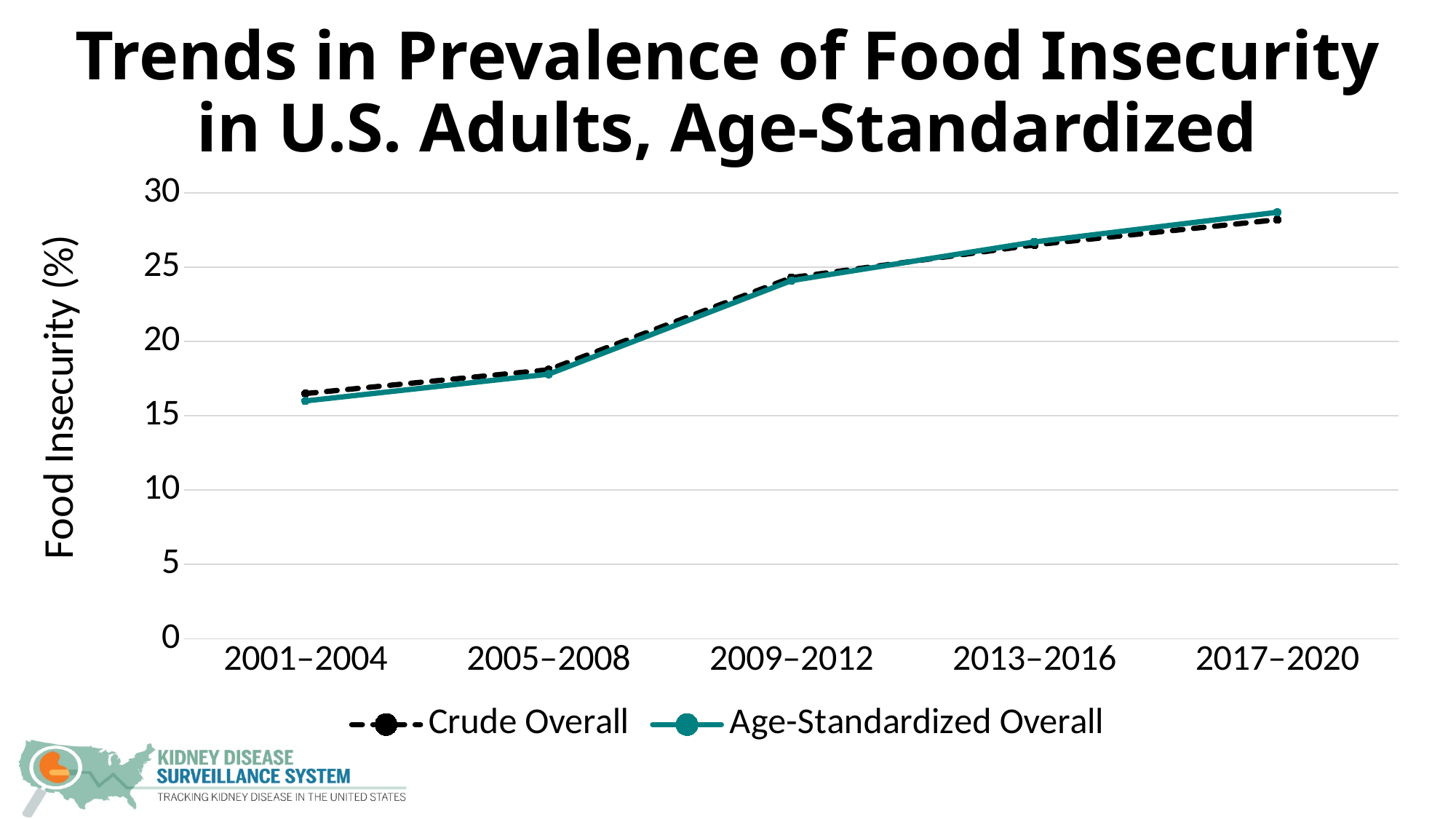
Is the Crude Overall value for 2017–2020 greater or less than 25? greater Is the Crude Overall value for 2005–2008 greater or less than 20? less How many series does the legend list? 2 Is the Age-Standardized Overall value for 2009–2012 greater or less than 20? greater Do the Age-Standardized Overall values rise or fall from 2001–2004 to 2017–2020? rise Which series is drawn with a dashed black line? Crude Overall Which period has the lowest Crude Overall value? 2001–2004 Which period has the highest Age-Standardized Overall value? 2017–2020 What is the label of the y axis? Food Insecurity (%) How many time periods are shown on the x axis? 5 What kind of chart is shown on the slide? line chart